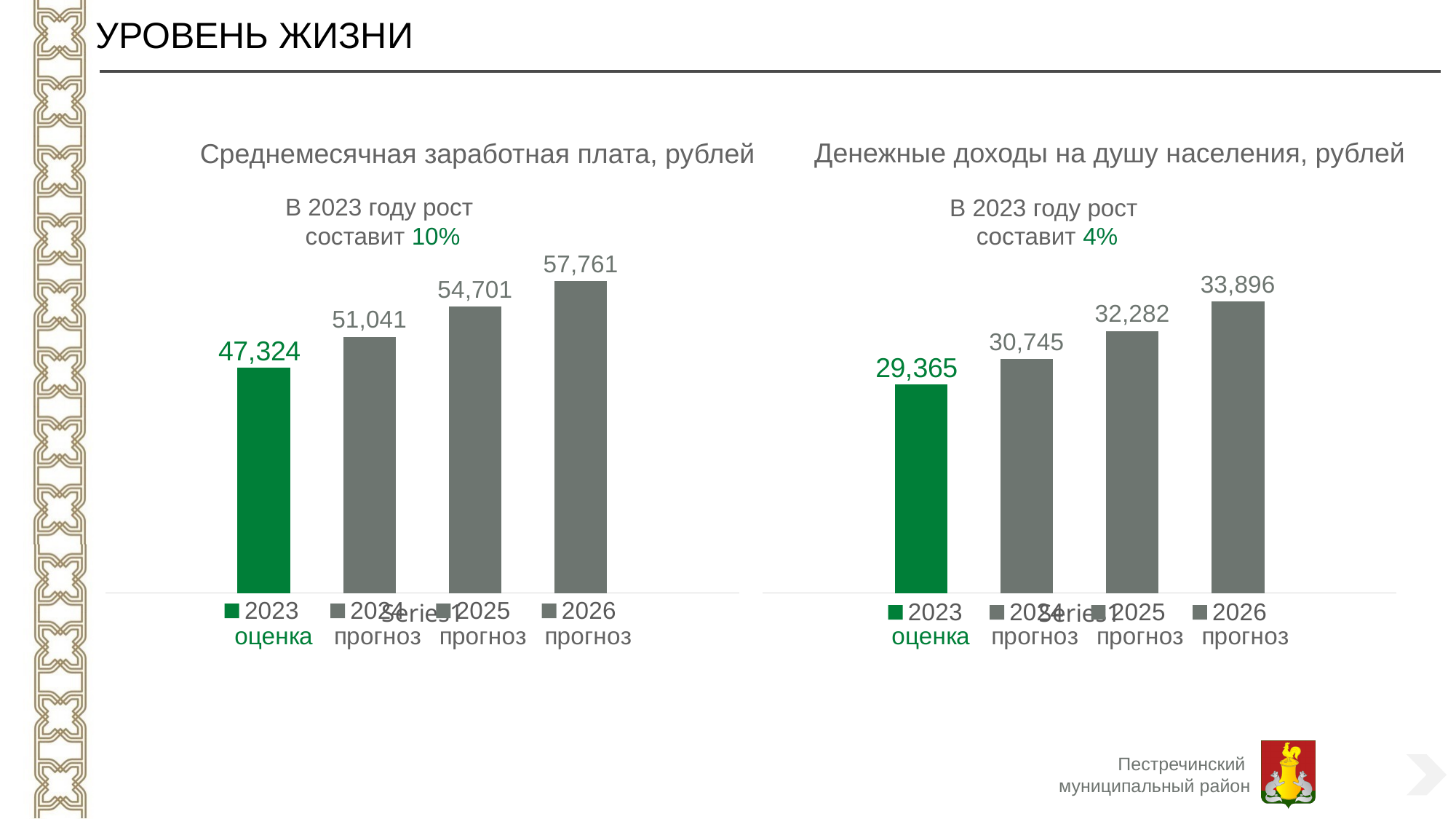
In the chart titled "Среднемесячная заработная плата, рублей", which year has the highest value? 2026 In the chart titled "Среднемесячная заработная плата, рублей", what is the value for 2026 (прогноз)? 57,761 In the chart titled "Денежные доходы на душу населения, рублей", which year has the lowest value? 2023 In the chart titled "Денежные доходы на душу населения, рублей", what is the difference between the 2026 value and the 2025 value? 1,614 In the chart titled "Среднемесячная заработная плата, рублей", which is larger: the value for 2024 or the value for 2025? 2025 In the chart titled "Денежные доходы на душу населения, рублей", what is the value for 2024 (прогноз)? 30,745 In the chart titled "Среднемесячная заработная плата, рублей", what is the difference between the 2026 value and the 2023 value? 10,437 In the chart titled "Среднемесячная заработная плата, рублей", what is the value for 2023 (оценка)? 47,324 In the chart titled "Денежные доходы на душу населения, рублей", what is the value for 2025 (прогноз)? 32,282 What type of chart is used for "Среднемесячная заработная плата, рублей"? Bar chart In the chart titled "Денежные доходы на душу населения, рублей", do the values rise or fall from 2023 to 2026? Rise How many bars are shown in the chart titled "Денежные доходы на душу населения, рублей"? 4